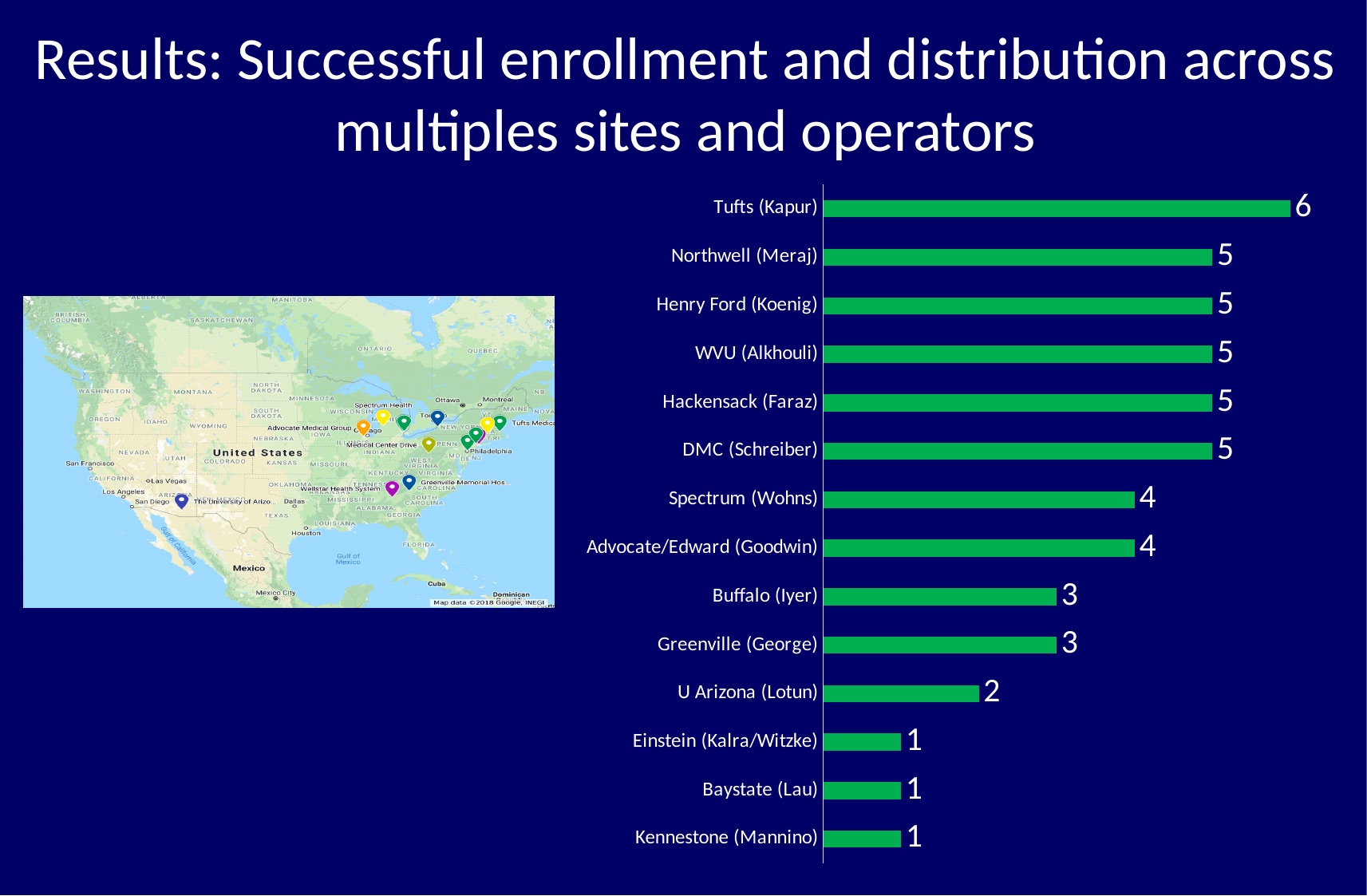
What is the value for U Arizona (Lotun)? 2 What is the value for Spectrum (Wohns)? 4 Which site has the highest value? Tufts (Kapur) How many sites are shown in the bar chart? 14 What colour are the bars in the chart? green Which is larger, the value for Advocate/Edward (Goodwin) or the value for Baystate (Lau)? Advocate/Edward (Goodwin) What is the value for Buffalo (Iyer)? 3 What is the difference between the values for Northwell (Meraj) and Greenville (George)? 2 What kind of chart is shown on the slide? bar chart How many sites have a value of 5? 5 What is the difference between the values for Tufts (Kapur) and Kennestone (Mannino)? 5 What is the value for Tufts (Kapur)? 6